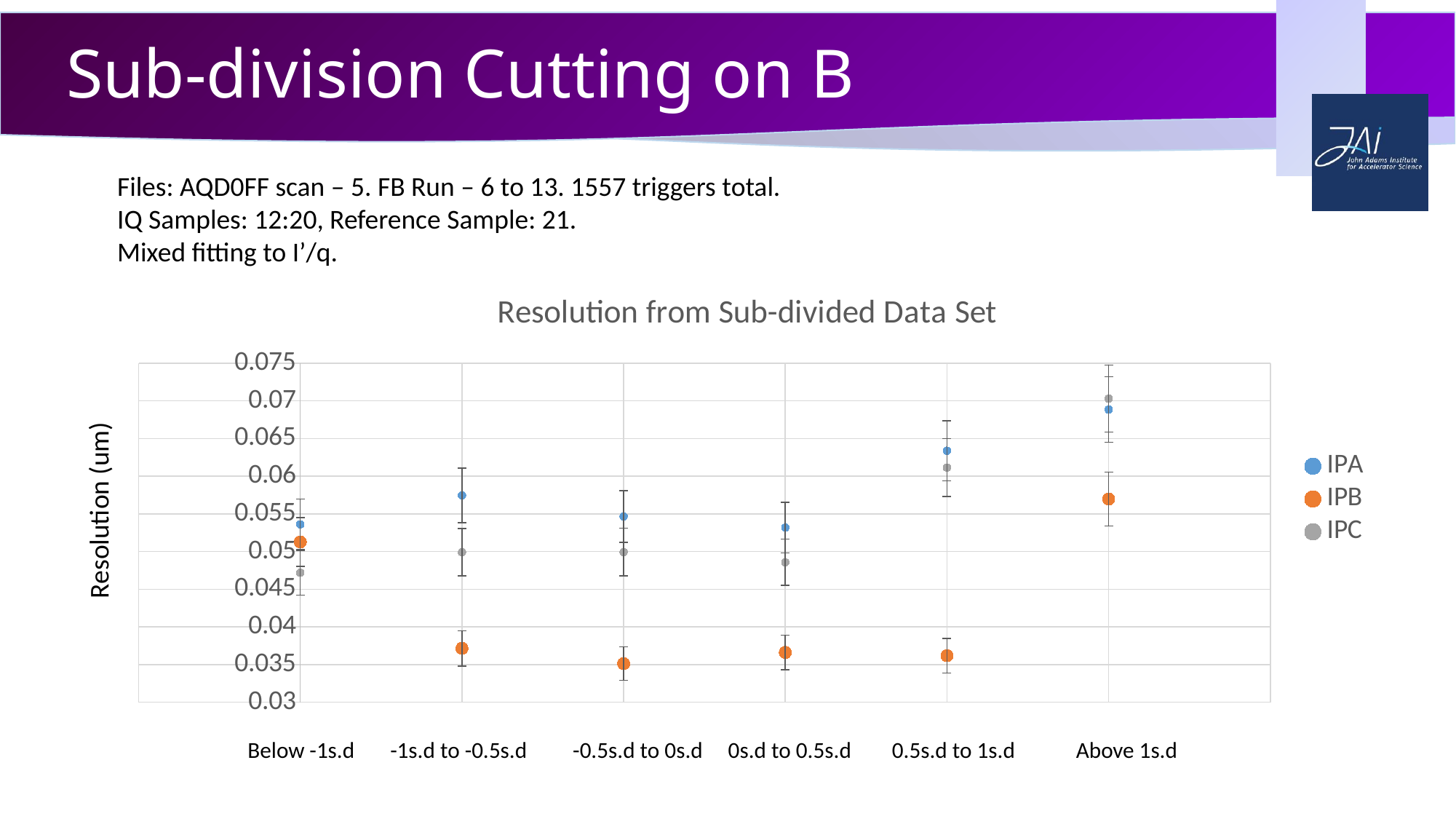
For which category is the IPB value highest? Above 1s.d What is the title of the chart? Resolution from Sub-divided Data Set Is the IPC value for Below -1s.d greater or less than 0.05? less How many series does the legend list? 3 For which category is the IPA value highest? Above 1s.d What is the label on the y axis? Resolution (um) How many categories are shown along the x axis? 6 Is the IPB value for Above 1s.d greater or less than 0.05? greater What kind of chart is shown on the slide? scatter chart Is the IPA value for 0.5s.d to 1s.d greater or less than 0.06? greater Which is larger for Below -1s.d, IPB or IPC? IPB Which is larger for -1s.d to -0.5s.d, IPA or IPB? IPA